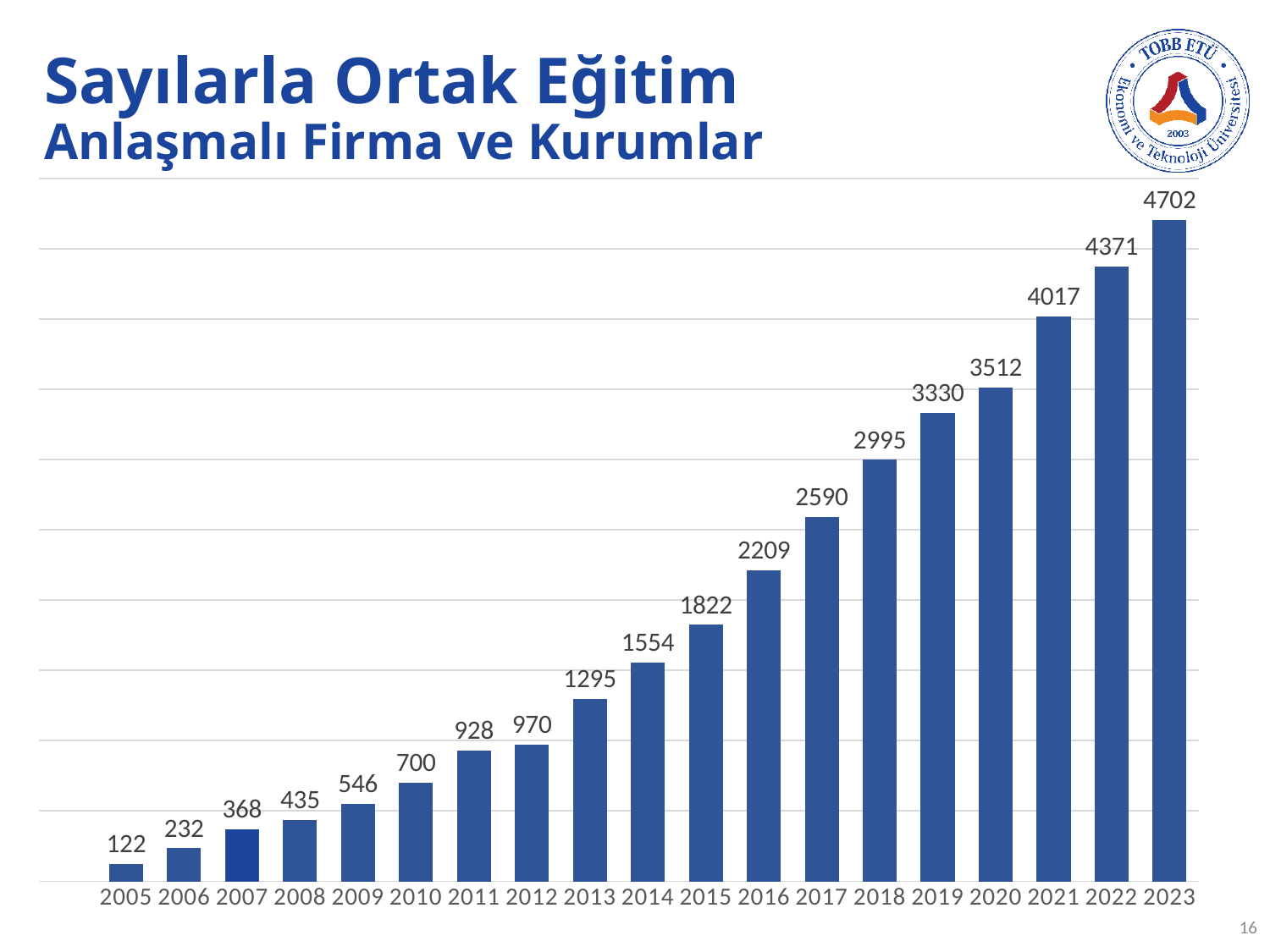
What is the value for 2020? 3512 What is the value for 2005? 122 How many years are shown on the x axis? 19 What is the difference between the values for 2023 and 2022? 331 Which year has the lowest value? 2005 What is the difference between the values for 2013 and 2012? 325 What is the value for 2015? 1822 Which year has the highest value? 2023 Which is larger, the value for 2017 or the value for 2016? 2017 What is the subtitle of the chart on the slide? Anlaşmalı Firma ve Kurumlar What kind of chart is shown on the slide? bar chart Do the values rise or fall from 2005 to 2023? rise